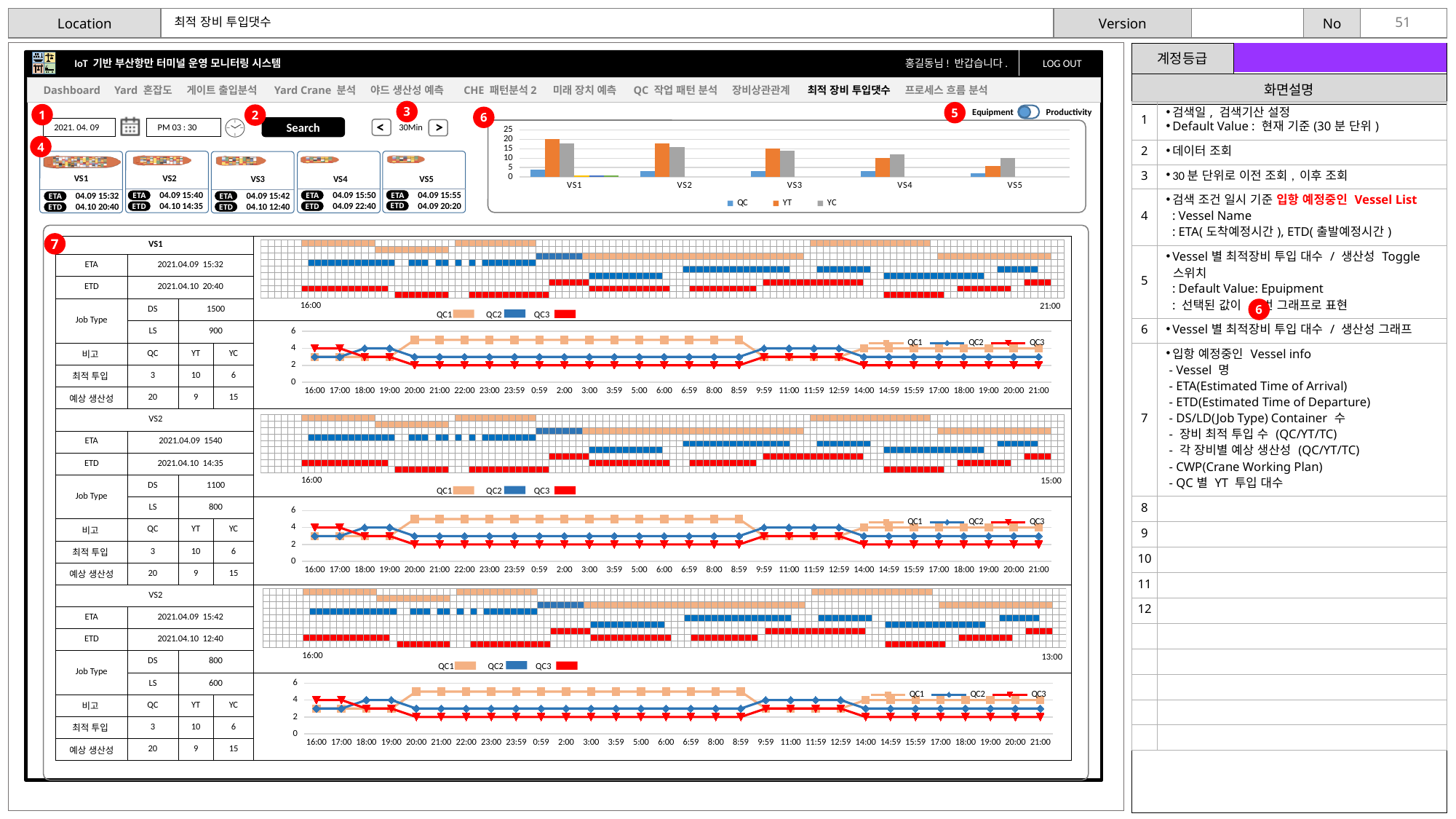
How many series does the legend of the top bar chart list? 3 In the top bar chart, is the YT value for VS1 greater or less than 15? greater In the top bar chart, is the YC value for VS5 greater or less than 15? less In the top bar chart, which vessel has the highest YT value? VS1 How many series does the legend of the first line chart (under VS1) list? 3 In the top bar chart, which is larger, the YT value for VS1 or the YT value for VS5? VS1 What kind of chart is the chart at the top of the dashboard showing VS1 to VS5? bar chart What kind of chart is the chart with the QC1, QC2 and QC3 legend under the VS1 table? line chart In the top bar chart, do the YT values rise or fall from VS1 to VS5? fall How many vessel categories are shown on the x axis of the top bar chart? 5 What are the three series names in the legend of the top bar chart? QC, YT, YC In the top bar chart, is the QC value for VS5 greater or less than 5? less